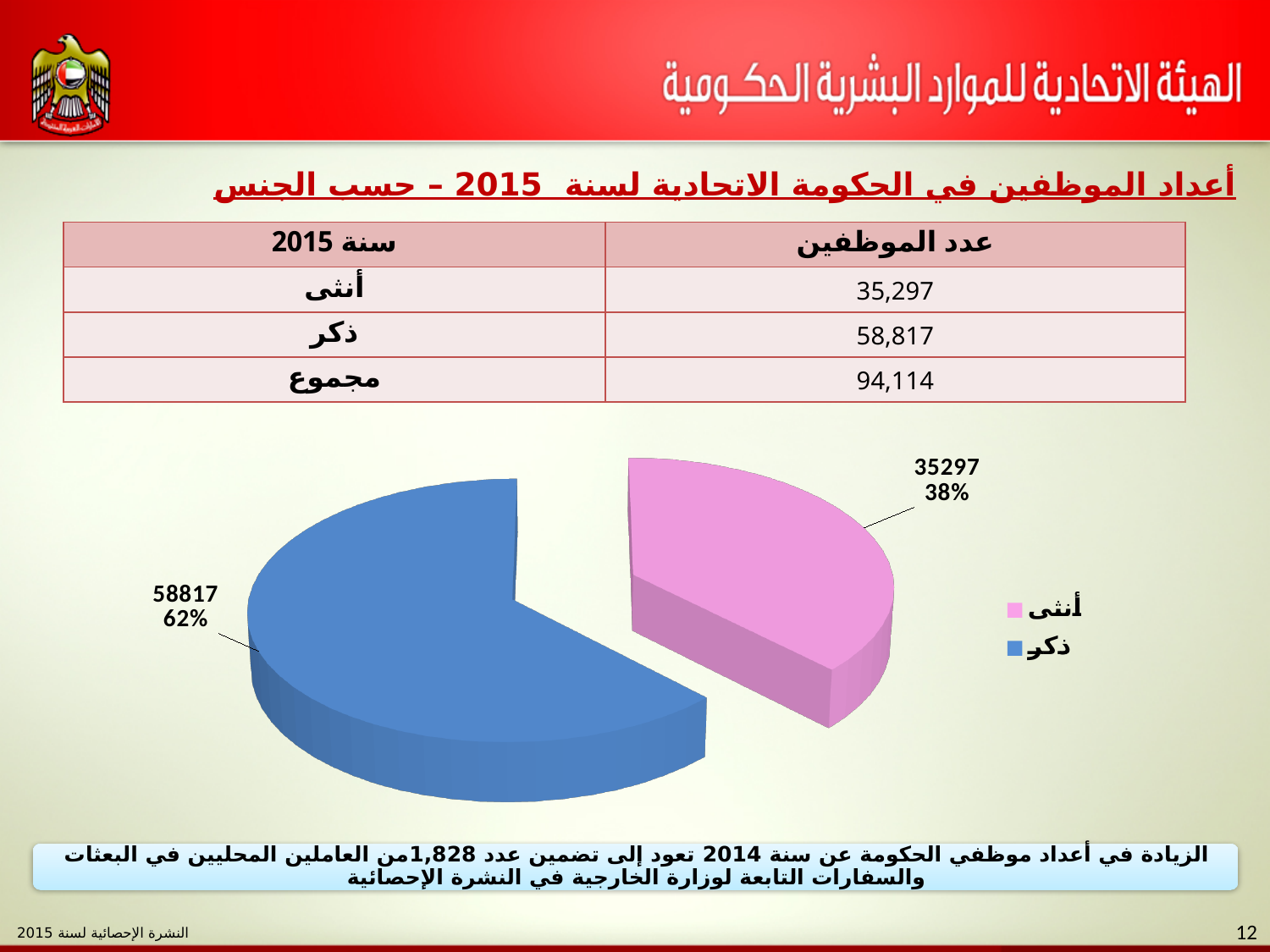
What percentage share of the pie does the ذكر slice have? 62% How many slices does the pie chart have? 2 What value is labelled on the pie slice for ذكر? 58817 What is the difference between the ذكر value and the أنثى value shown on the pie chart? 23520 What percentage share of the pie does the أنثى slice have? 38% What kind of chart is shown on the slide? pie chart Which is larger in the pie chart, the value for ذكر or the value for أنثى? ذكر How many entries does the pie chart's legend list? 2 Which slice of the pie chart is the smallest? أنثى What value is labelled on the pie slice for أنثى? 35297 Which slice of the pie chart is the largest? ذكر What colour is the ذكر slice in the pie chart? blue